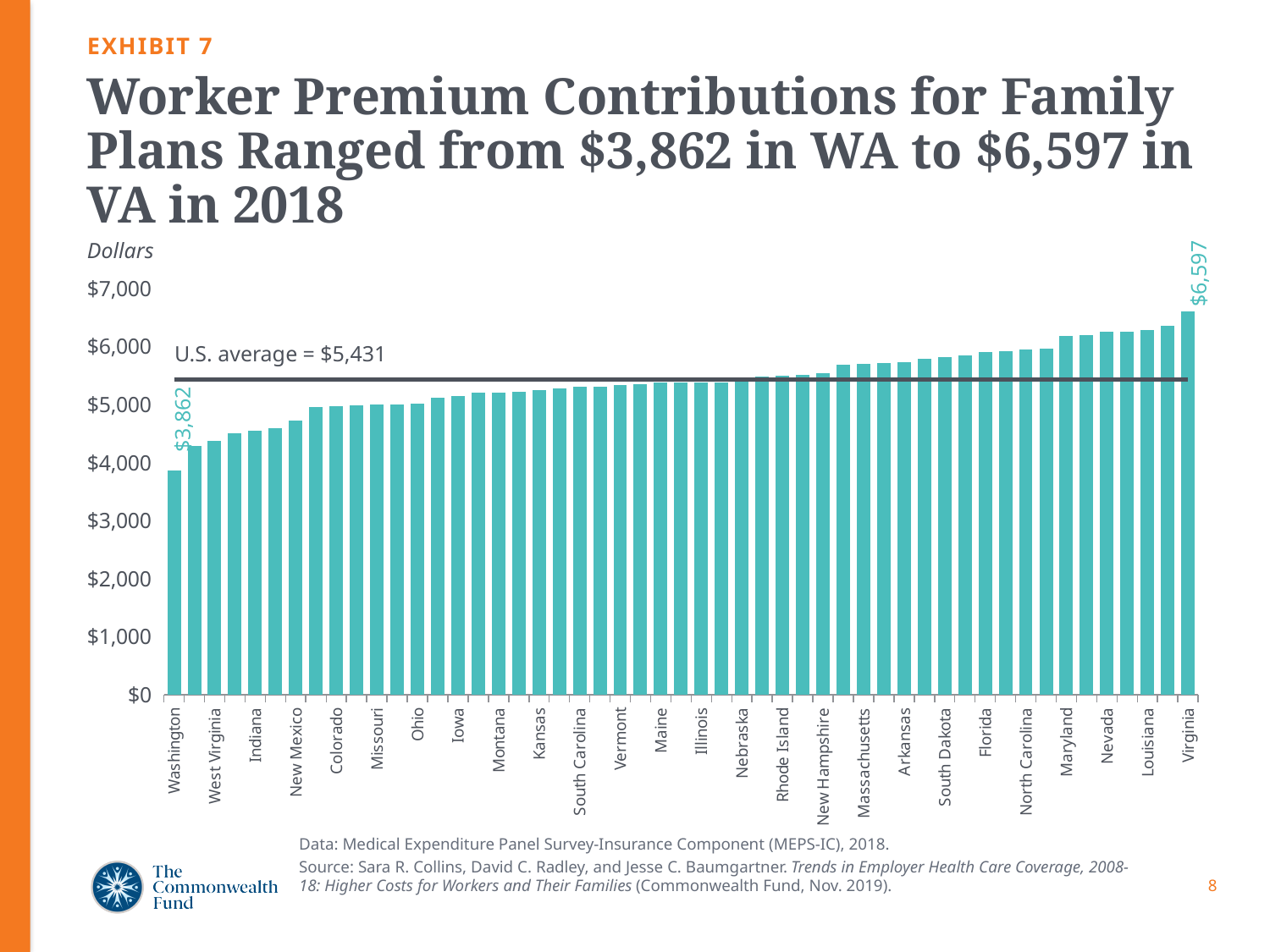
What is the difference between the worker premium contribution in Virginia and in Washington? $2,735 Which state has a larger worker premium contribution, Nevada or Colorado? Nevada What is the worker premium contribution for family plans in Virginia? $6,597 What U.S. average value is marked by the horizontal line on the chart? $5,431 Is the value for Florida greater or less than $5,000? greater What is the worker premium contribution for family plans in Washington? $3,862 Is the value for Kansas greater or less than $6,000? less What kind of chart is shown on the slide? bar chart Which state has the highest worker premium contribution for family plans? Virginia Is the value for Indiana greater or less than $5,000? less Which state has the lowest worker premium contribution for family plans? Washington Do the bar values rise or fall from left to right across the states? rise